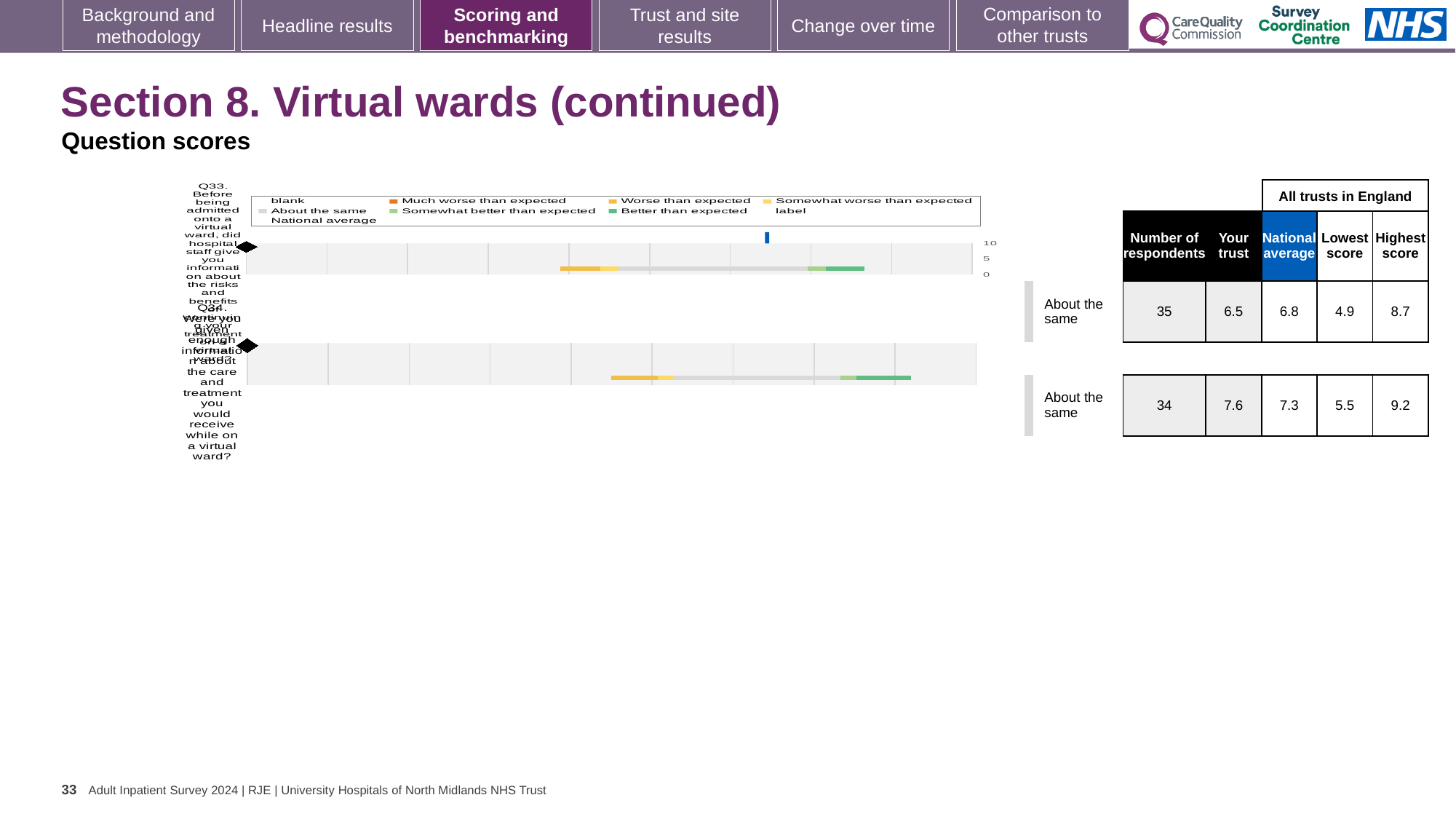
What is the 'Your trust' score for Q33 (information about the risks and benefits of a virtual ward)? 6.5 What is the national average score for Q34? 7.3 What kind of chart is shown on the slide? bar chart What is the national average score for Q33? 6.8 How many respondents answered Q34? 34 How many questions (categories) are plotted in the chart? 2 What benchmarking category is shown for both Q33 and Q34? About the same What is the difference between the highest and lowest scores for Q33 across all trusts in England? 3.8 What is the highest score among all trusts in England for Q34? 9.2 What is the 'Your trust' score for Q34 (enough information about the care and treatment on a virtual ward)? 7.6 Which question has the higher 'Your trust' score, Q33 or Q34? Q34 What is the lowest score among all trusts in England for Q33? 4.9